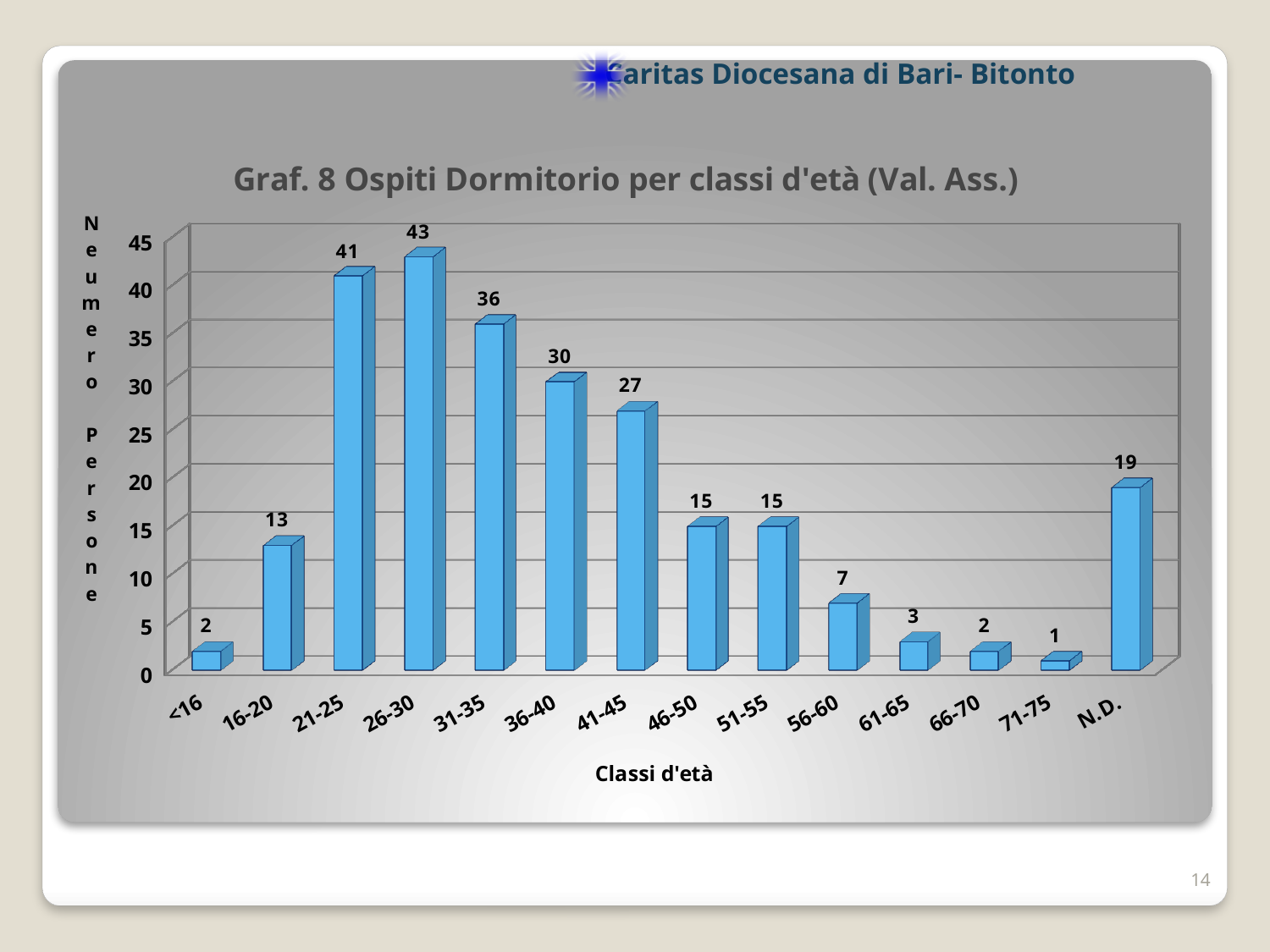
What is the difference between the values for 21-25 and 31-35? 5 How many categories are shown on the x axis? 14 What is the title of the chart? Graf. 8 Ospiti Dormitorio per classi d'età (Val. Ass.) Which age class has the lowest value? 71-75 What is the value for the 26-30 age class? 43 What is the label of the x axis? Classi d'età What kind of chart is shown on the slide? Bar chart What is the value for the N.D. category? 19 Do the values rise or fall from 26-30 to 71-75 along the x axis? Fall Which is larger, the value for 36-40 or the value for 41-45? 36-40 What is the value for the 16-20 age class? 13 Which age class has the highest value? 26-30